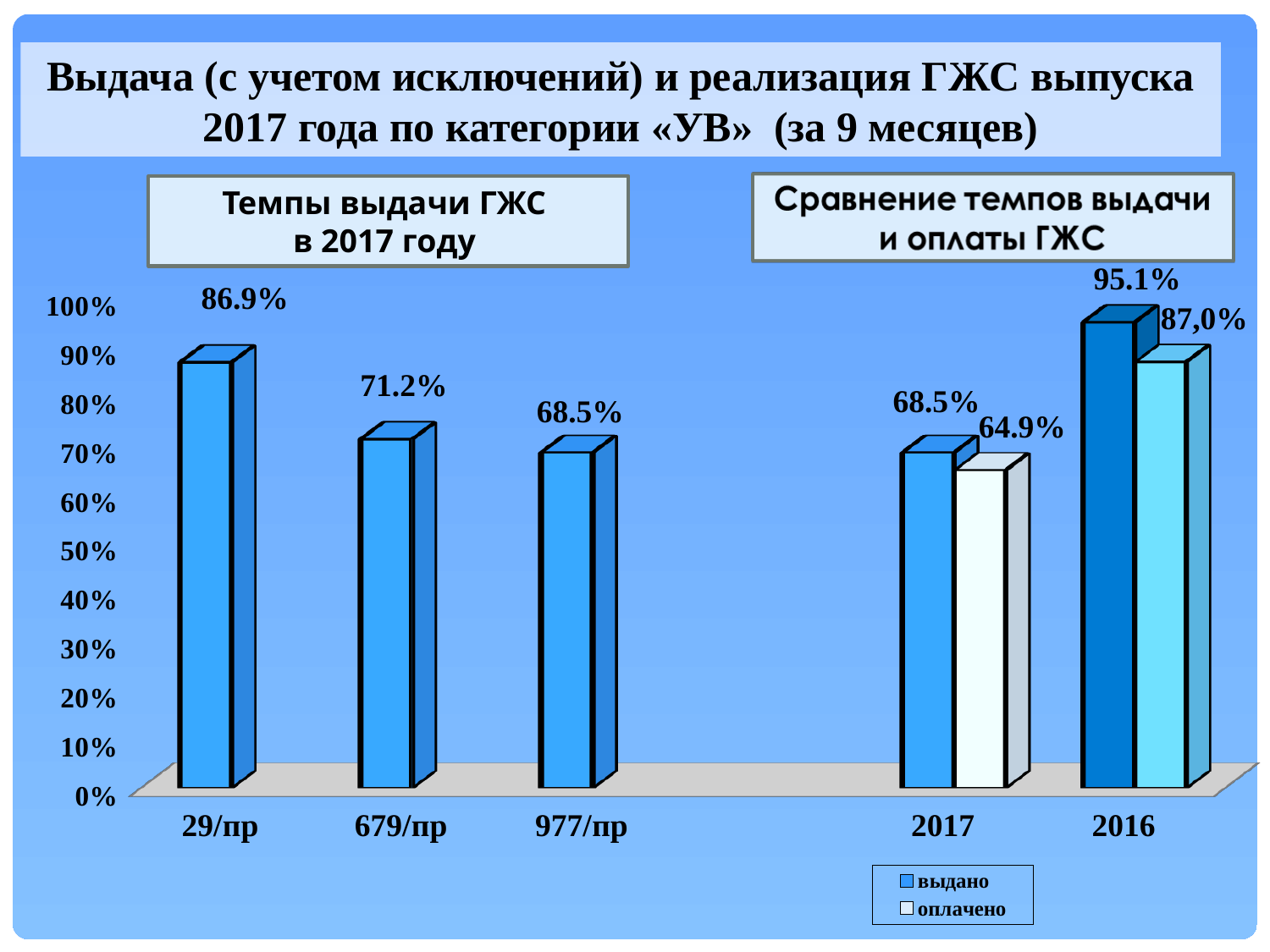
In the chart 'Сравнение темпов выдачи и оплаты ГЖС', what is the 'оплачено' value for 2016? 87,0% In the chart 'Темпы выдачи ГЖС в 2017 году', how many categories are shown? 3 In the chart 'Темпы выдачи ГЖС в 2017 году', which category has the lowest value? 977/пр What kind of chart is 'Темпы выдачи ГЖС в 2017 году'? bar chart In the chart 'Сравнение темпов выдачи и оплаты ГЖС', which is larger for 2017: 'выдано' or 'оплачено'? выдано In the chart 'Темпы выдачи ГЖС в 2017 году', what is the value for 679/пр? 71.2% In the chart 'Сравнение темпов выдачи и оплаты ГЖС', how many series does the legend list? 2 In the chart 'Сравнение темпов выдачи и оплаты ГЖС', what is the 'выдано' value for 2016? 95.1% In the chart 'Темпы выдачи ГЖС в 2017 году', which category has the highest value? 29/пр In the chart 'Темпы выдачи ГЖС в 2017 году', what is the value for 29/пр? 86.9% In the chart 'Сравнение темпов выдачи и оплаты ГЖС', what is the 'оплачено' value for 2017? 64.9% In the chart 'Темпы выдачи ГЖС в 2017 году', do the values rise or fall from 29/пр to 977/пр? fall